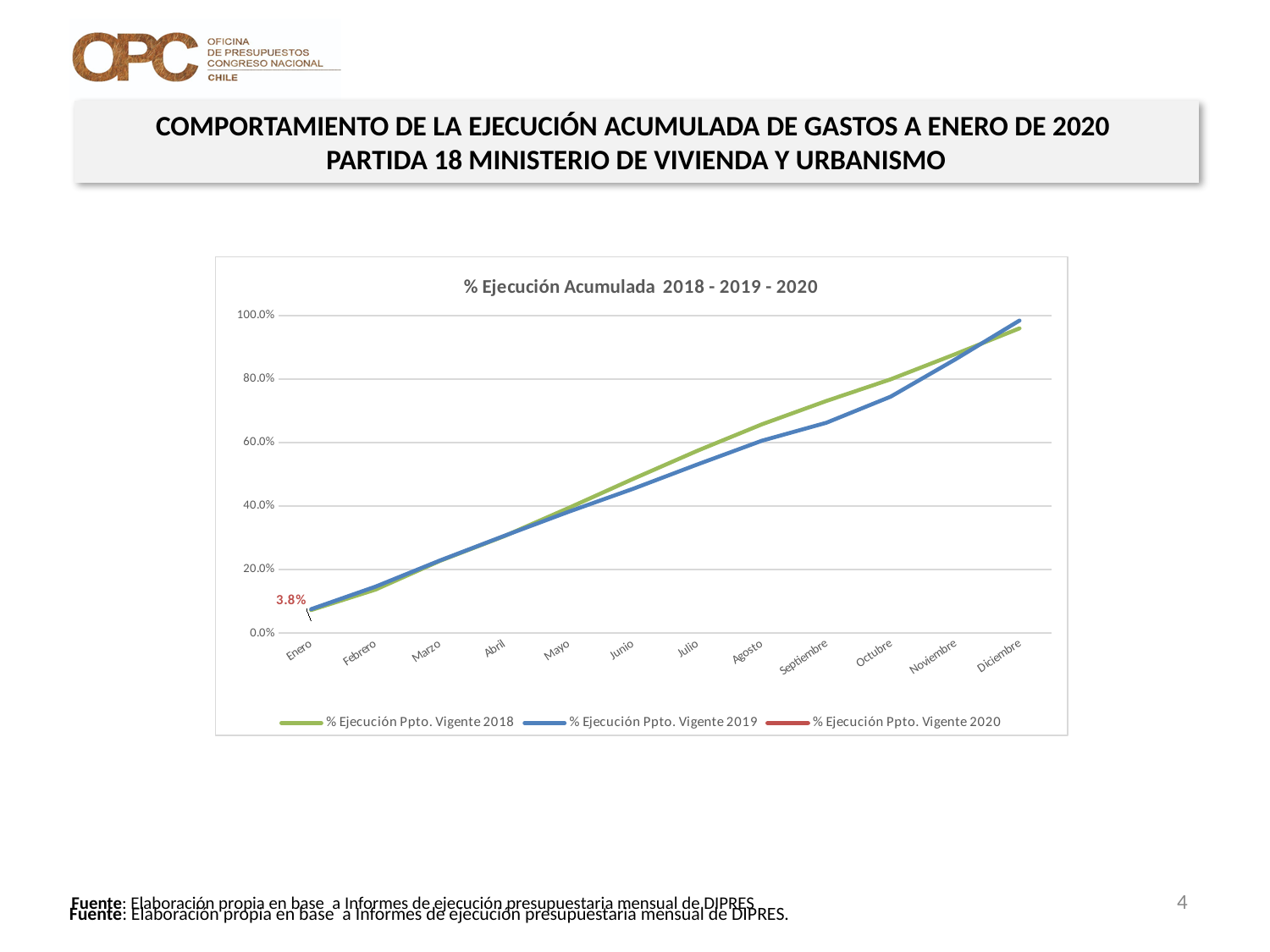
Is the value for % Ejecución Ppto. Vigente 2018 in Junio greater or less than 40.0%? greater In Octubre, which series has the higher value: % Ejecución Ppto. Vigente 2018 or % Ejecución Ppto. Vigente 2019? % Ejecución Ppto. Vigente 2018 In which month does % Ejecución Ppto. Vigente 2019 reach its highest value? Diciembre Do the values for % Ejecución Ppto. Vigente 2019 rise or fall from Enero to Diciembre? rise Is the value for % Ejecución Ppto. Vigente 2019 in Diciembre greater or less than 80.0%? greater What is the title of the chart? % Ejecución Acumulada 2018 - 2019 - 2020 Is the value for % Ejecución Ppto. Vigente 2019 in Octubre greater or less than 80.0%? less How many months are shown along the x axis of the chart? 12 What value is printed as a data label at Enero on the chart? 3.8% How many series does the chart legend list? 3 In which month is the value for % Ejecución Ppto. Vigente 2018 lowest? Enero What kind of chart is shown on the slide? line chart